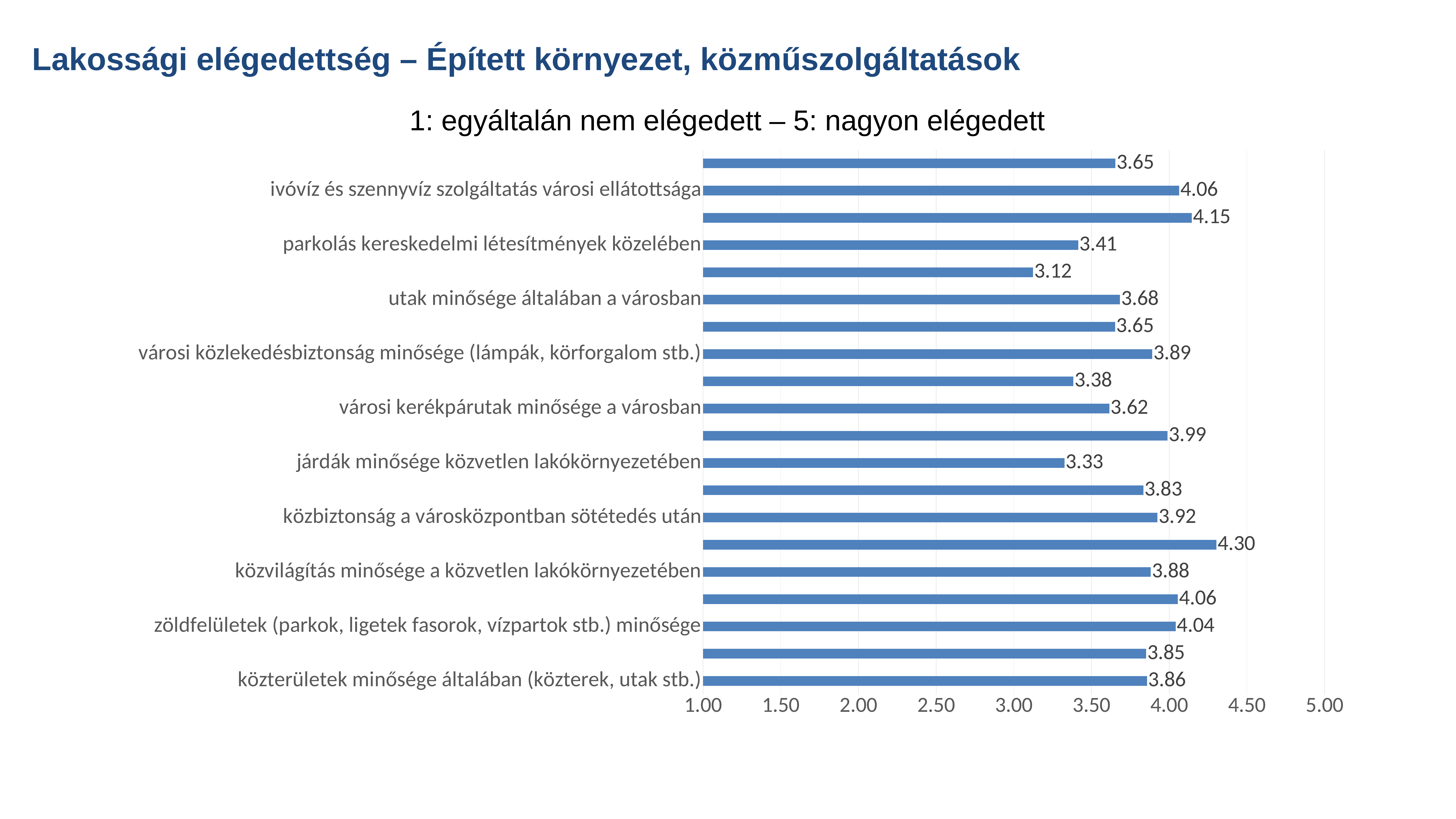
What is the difference between the values for 'utak minősége általában a városban' and 'városi kerékpárutak minősége a városban'? 0.06 What is the value for 'parkolás kereskedelmi létesítmények közelében'? 3.41 What is the value for 'ivóvíz és szennyvíz szolgáltatás városi ellátottsága'? 4.06 What is the value for 'zöldfelületek (parkok, ligetek fasorok, vízpartok stb.) minősége'? 4.04 Is the value for 'közterületek minősége általában (közterek, utak stb.)' greater or less than 3.50? greater Which has a higher value: 'városi közlekedésbiztonság minősége (lámpák, körforgalom stb.)' or 'közvilágítás minősége a közvetlen lakókörnyezetében'? városi közlekedésbiztonság minősége (lámpák, körforgalom stb.) How many bars are plotted in the chart? 20 What is the value for 'járdák minősége közvetlen lakókörnyezetében'? 3.33 What is the value for 'közbiztonság a városközpontban sötétedés után'? 3.92 What is the largest value printed on any bar in the chart? 4.30 What kind of chart is shown on the slide? bar chart What is the smallest value printed on any bar in the chart? 3.12